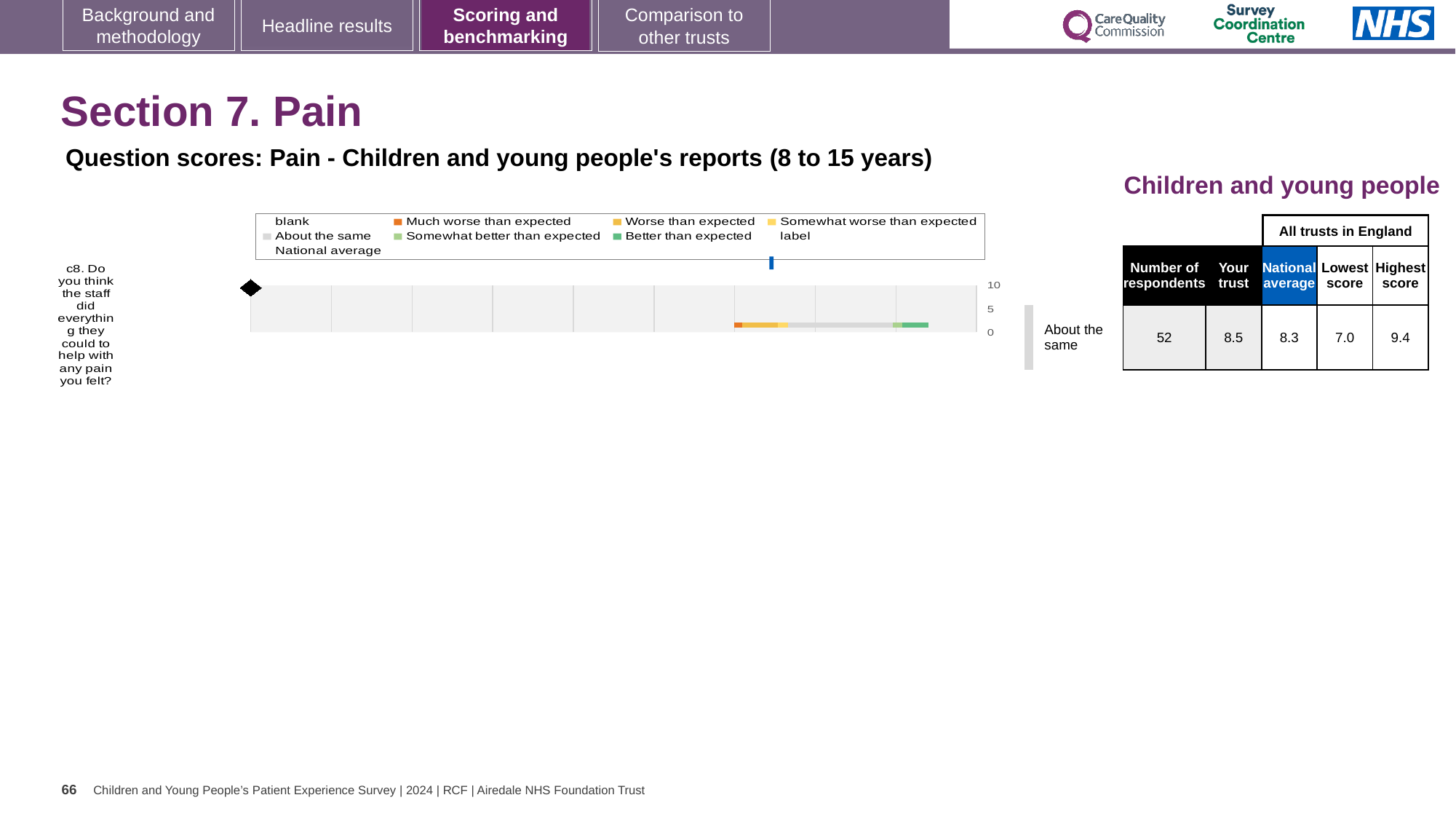
In the table beside the chart, how many respondents answered question c8? 52 For question c8, what is the difference between the highest score and the lowest score among all trusts in England? 2.4 What benchmark category is shown for question c8 next to the chart? About the same For question c8, which is higher: the 'Your trust' score or the national average? Your trust In the table beside the chart, what is the highest score among all trusts in England for question c8? 9.4 How many survey questions are plotted in the chart? 1 In the table beside the chart, what is the national average score for question c8? 8.3 In the table beside the chart, what is the lowest score among all trusts in England for question c8? 7.0 What is the highest tick value shown on the chart's score axis? 10 In the table beside the chart, what is the 'Your trust' score for question c8? 8.5 What colour does the legend use for 'About the same'? grey What kind of chart is shown on the slide? bar chart